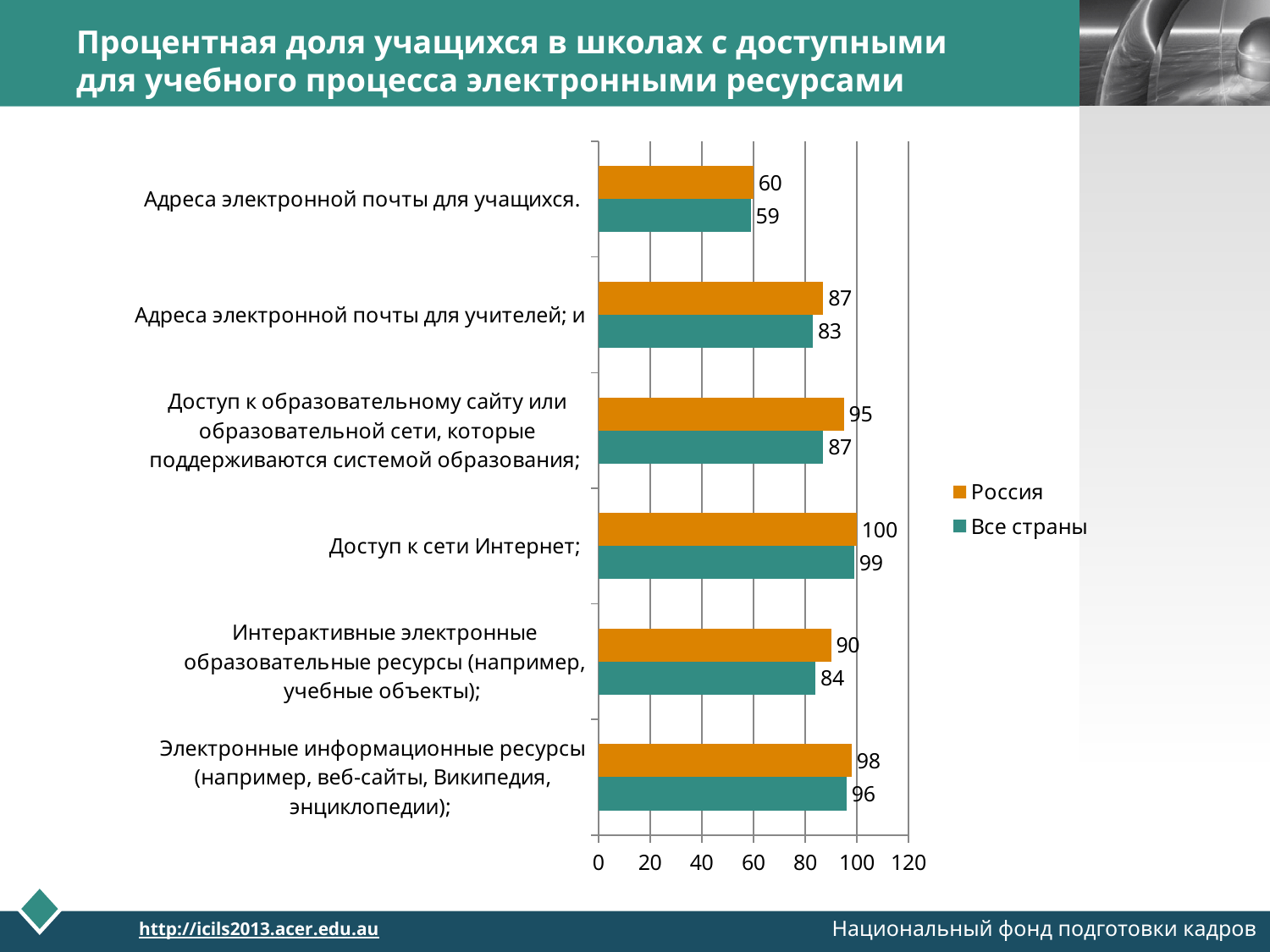
How many categories are shown on the chart? 6 Which category has the highest value for Россия? Доступ к сети Интернет; Which is larger for "Адреса электронной почты для учителей; и": Россия or Все страны? Россия What value is shown for Россия for "Интерактивные электронные образовательные ресурсы (например, учебные объекты);"? 90 What value is shown for Россия for "Доступ к сети Интернет;"? 100 Which series is shown in orange in the legend? Россия What value is shown for Все страны for "Адреса электронной почты для учащихся."? 59 Which category has the lowest value for Все страны? Адреса электронной почты для учащихся. How many series does the legend list? 2 What is the difference between Россия and Все страны for "Доступ к образовательному сайту или образовательной сети, которые поддерживаются системой образования;"? 8 Is the value for Все страны for "Электронные информационные ресурсы (например, веб-сайты, Википедия, энциклопедии);" greater or less than 80? greater What kind of chart is shown on the slide? bar chart